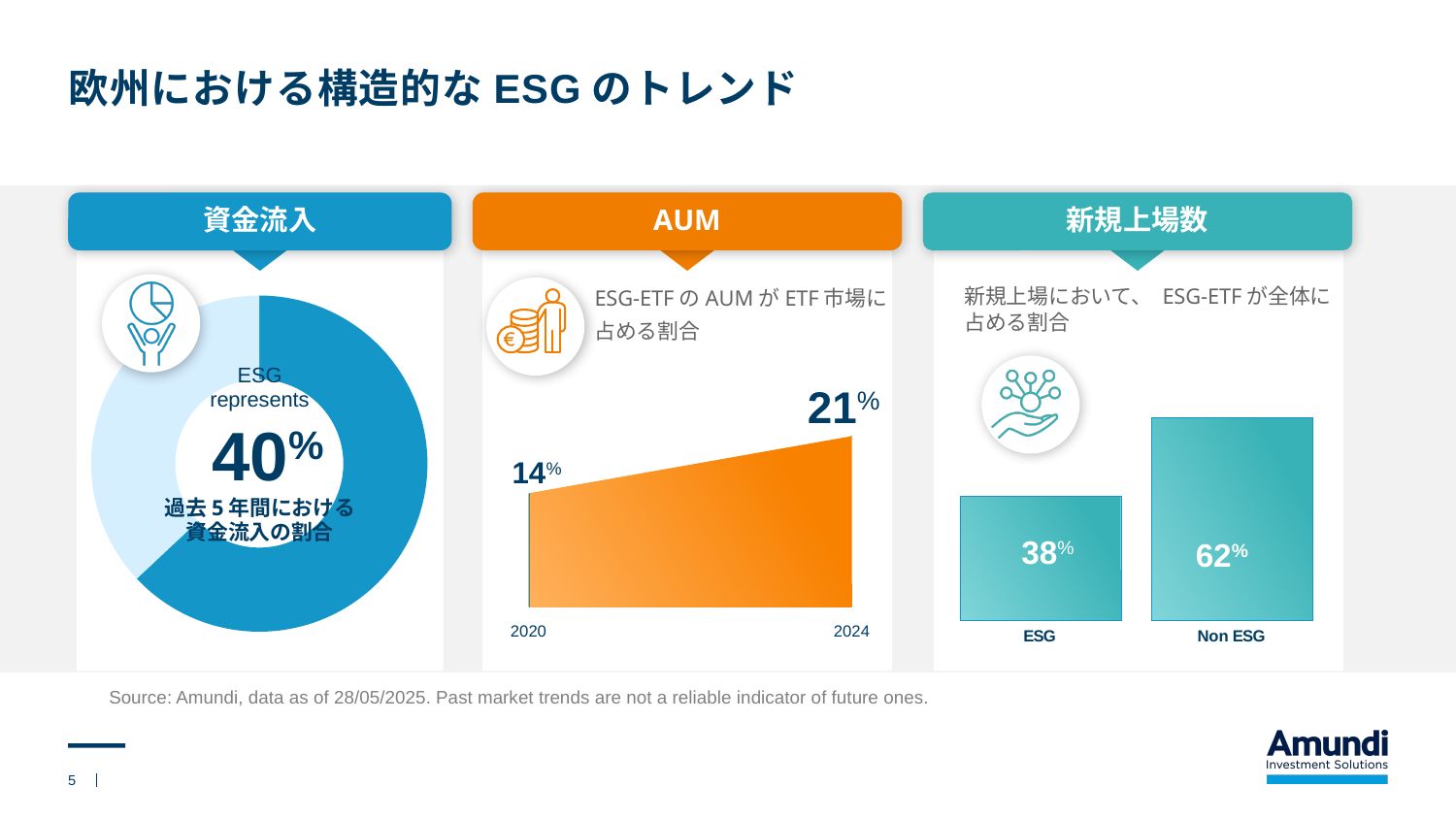
In the 新規上場数 chart on the right, what share of new listings is ESG? 38% In the AUM chart in the middle, by how many percentage points did the ESG-ETF share rise from 2020 to 2024? 7 percentage points What kind of chart is shown in the AUM panel in the middle? Area chart In the AUM chart in the middle, what was the ESG-ETF share of the ETF market in 2024? 21% In the 新規上場数 chart on the right, what is the difference between the Non ESG and ESG shares? 24 percentage points What kind of chart is shown in the 資金流入 panel on the left? Donut (pie) chart In the 新規上場数 chart on the right, which category is higher, ESG or Non ESG? Non ESG In the AUM chart in the middle, does the ESG-ETF share rise or fall from 2020 to 2024? Rise How many bars are shown in the 新規上場数 chart on the right? 2 In the AUM chart in the middle, what was the ESG-ETF share of the ETF market in 2020? 14% In the 資金流入 chart on the left, what share of fund inflows over the past 5 years does ESG represent? 40% In the 新規上場数 chart on the right, what share of new listings is Non ESG? 62%